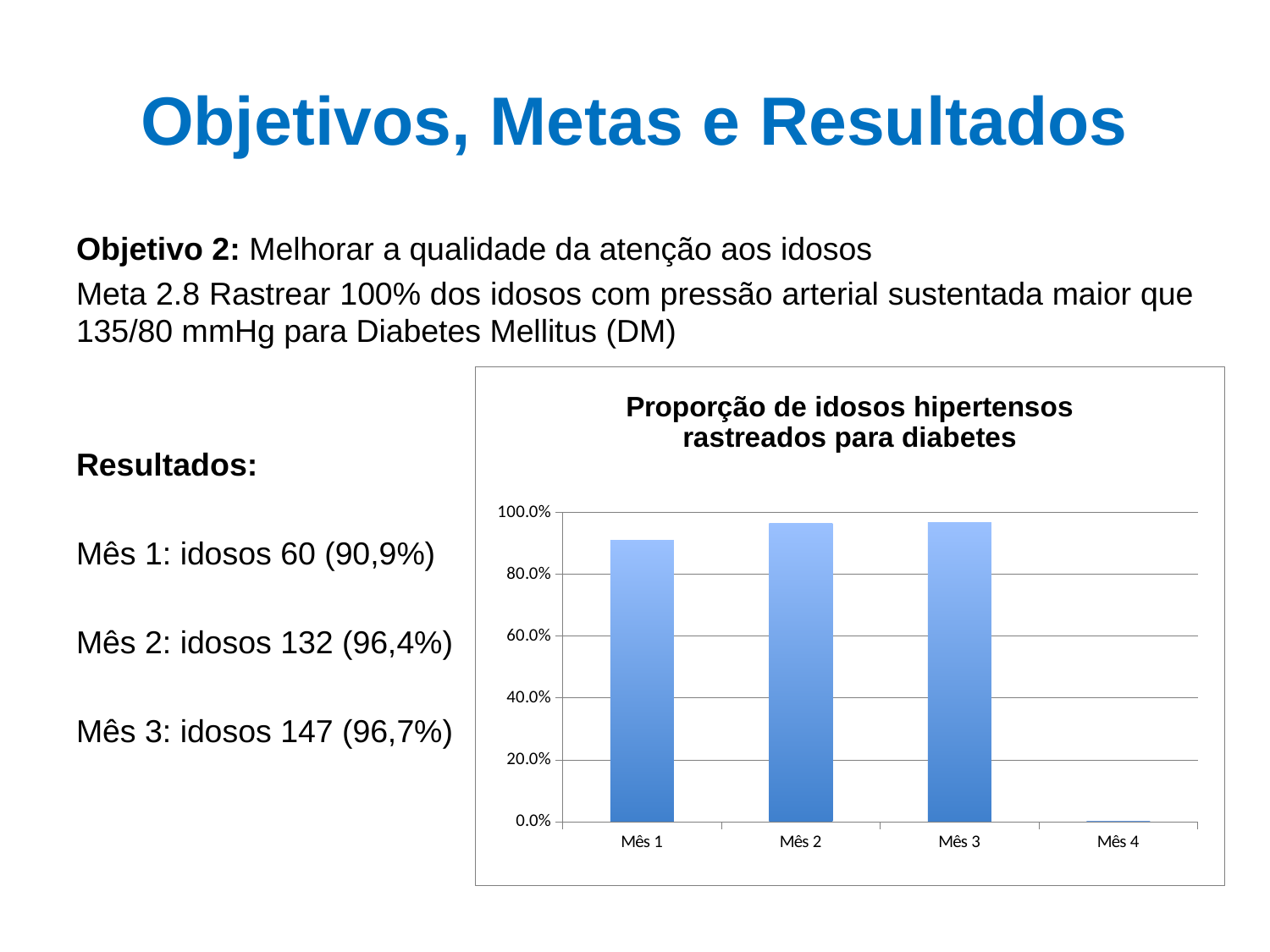
According to the results text on the slide, what proportion was reached in Mês 3? 96,7% Is the value for Mês 1 greater or less than 80.0%? greater Which bar is taller, Mês 3 or Mês 4? Mês 3 Is the value for Mês 4 greater or less than 20.0%? less Which month has the lowest bar in the chart? Mês 4 Does the value rise or fall from Mês 1 to Mês 2? rise Is the value for Mês 2 greater or less than 100.0%? less What kind of chart is shown on the slide? bar chart What is the title of the chart? Proporção de idosos hipertensos rastreados para diabetes Which bar is taller, Mês 1 or Mês 2? Mês 2 How many months (categories) are shown on the x axis of the chart? 4 According to the results text on the slide, what proportion was reached in Mês 1? 90,9%